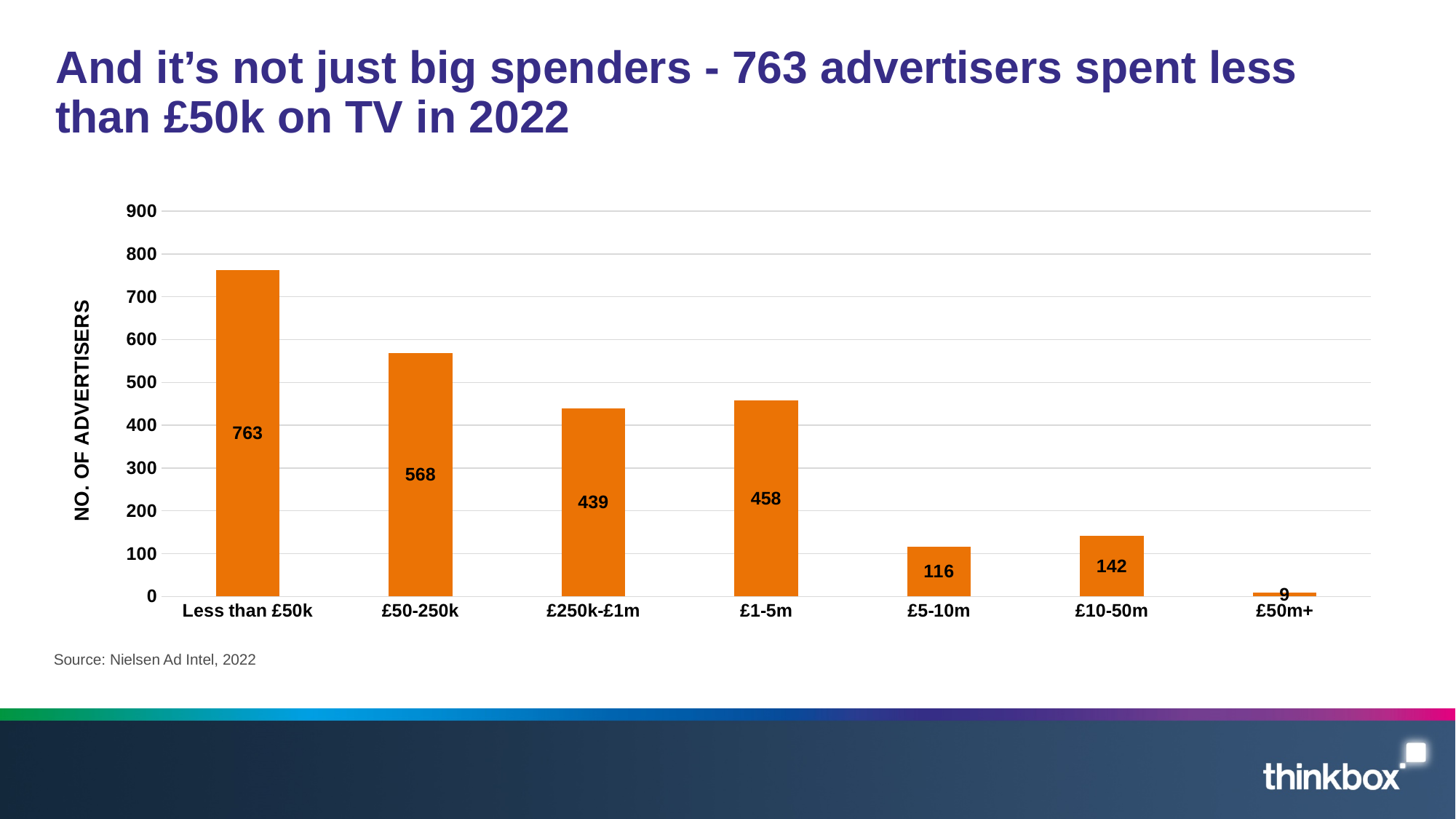
What is the difference in the number of advertisers between the Less than £50k band and the £50-250k band? 195 Which spend band has the highest number of advertisers? Less than £50k How many spend bands are shown on the chart? 7 What is the number of advertisers in the £1-5m spend band? 458 What kind of chart is shown on the slide? Bar chart What is the number of advertisers in the £50m+ spend band? 9 What is the difference in the number of advertisers between the £10-50m band and the £5-10m band? 26 Is the value for the £50-250k band greater or less than 500? greater Which has more advertisers, the £250k-£1m band or the £1-5m band? £1-5m What is the label of the vertical axis? NO. OF ADVERTISERS Which spend band has the lowest number of advertisers? £50m+ How many advertisers spent less than £50k on TV in 2022? 763